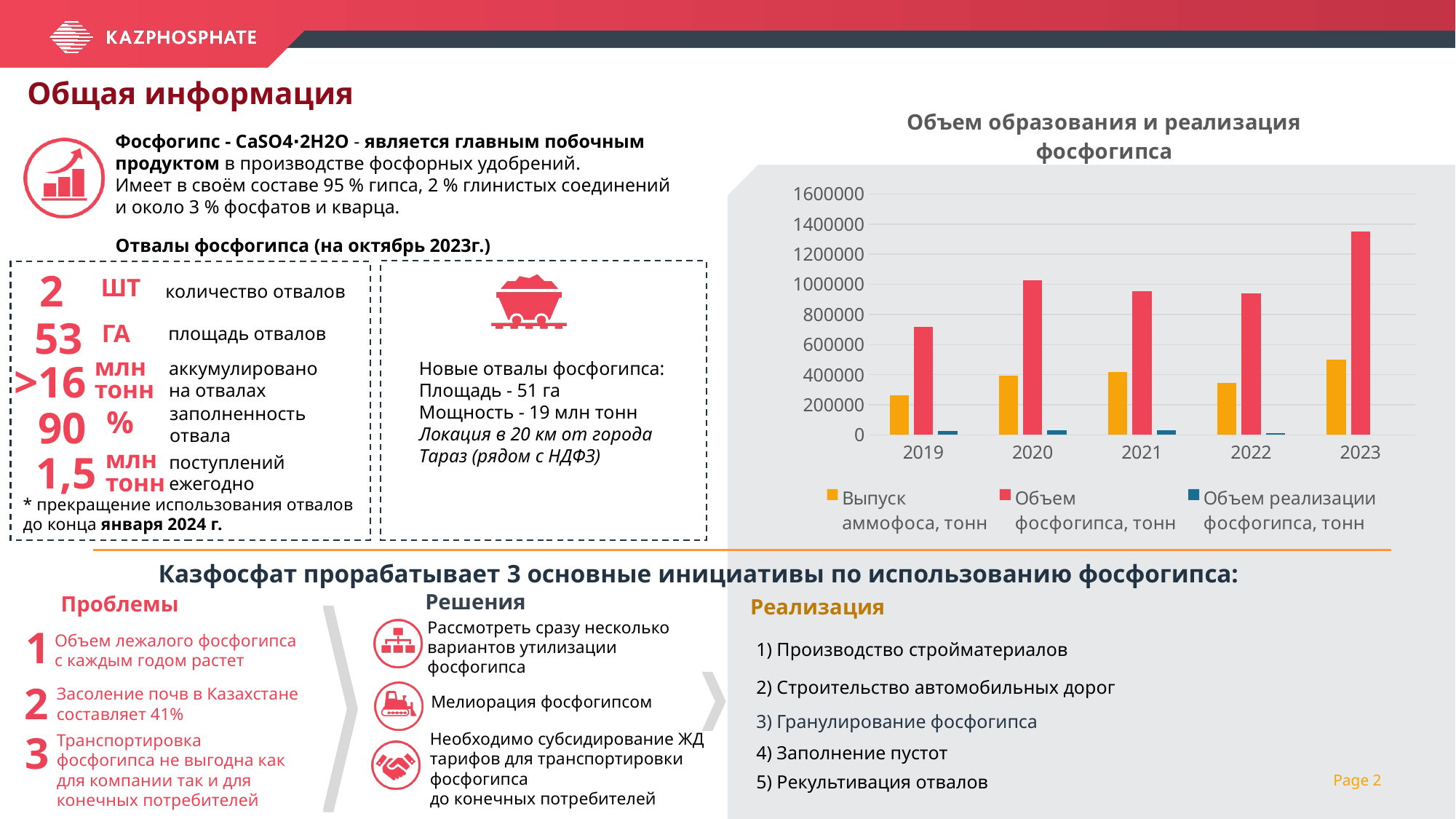
Is the value for 'Объем фосфогипса, тонн' in 2019 greater or less than 800000? less In which year is the value for 'Объем фосфогипса, тонн' the highest? 2023 Is the value for 'Объем фосфогипса, тонн' in 2023 greater or less than 1200000? greater In which year is the value for 'Выпуск аммофоса, тонн' the lowest? 2019 In which year is the value for 'Объем фосфогипса, тонн' the lowest? 2019 What kind of chart is shown on the slide? bar chart Which year has the larger value for 'Выпуск аммофоса, тонн': 2021 or 2022? 2021 Is the value for 'Выпуск аммофоса, тонн' in 2019 greater or less than 200000? greater In which year is the value for 'Выпуск аммофоса, тонн' the highest? 2023 How many series does the chart legend list? 3 How many years are shown on the x axis of the chart? 5 What is the title of the chart? Объем образования и реализация фосфогипса